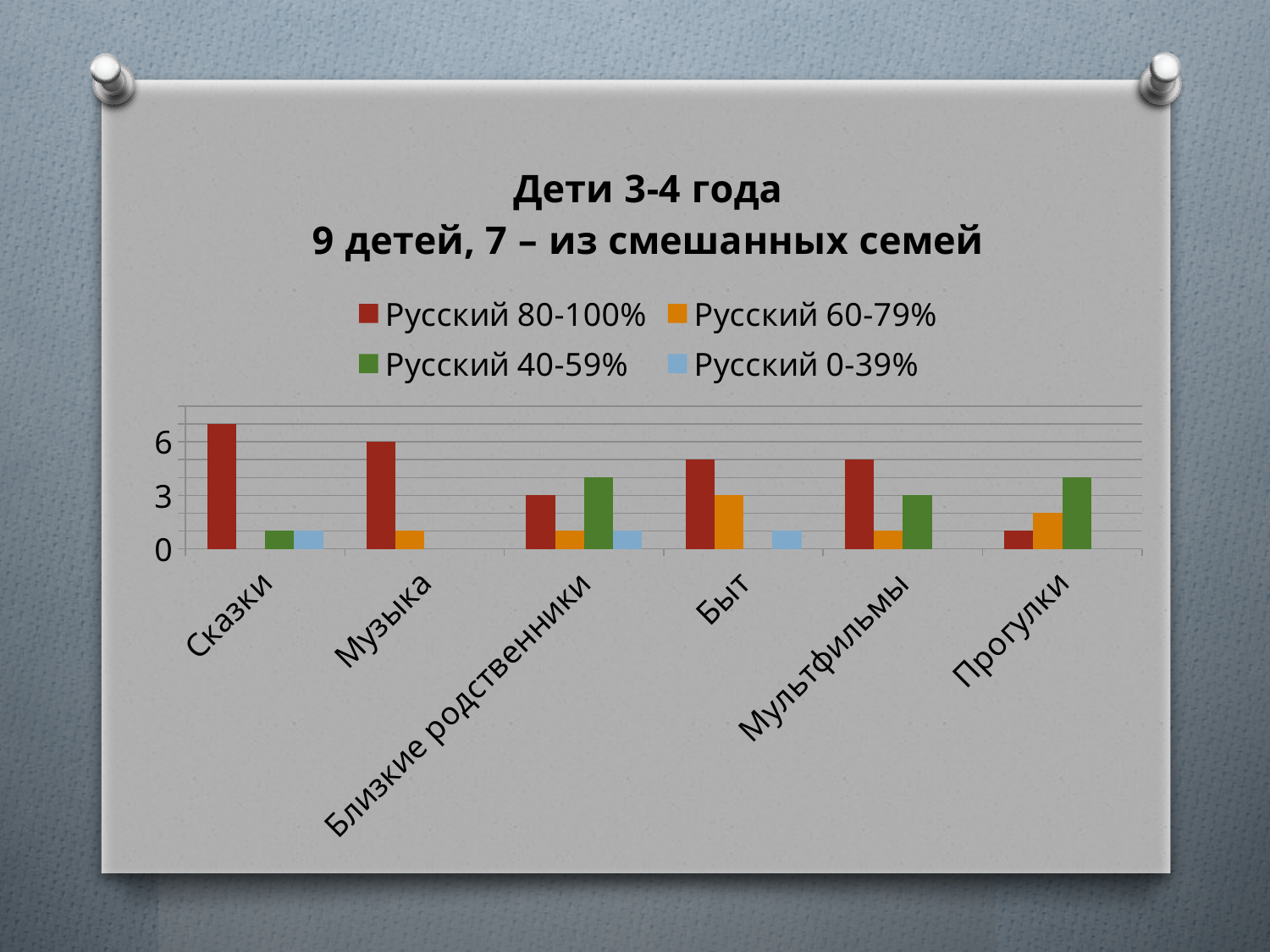
What is the value of the Русский 80-100% series for Близкие родственники? 3 What is the value of the Русский 40-59% series for Мультфильмы? 3 What is the value of the Русский 80-100% series for Музыка? 6 How many categories are shown on the x axis? 6 What kind of chart is shown on the slide? bar chart For Быт, which series has the larger value: Русский 80-100% or Русский 60-79%? Русский 80-100% Is the value of the Русский 40-59% series for Прогулки greater or less than 3? greater Is the value of the Русский 80-100% series for Сказки greater or less than 6? greater Which category has the highest value for the Русский 80-100% series? Сказки Which category has the lowest value for the Русский 80-100% series? Прогулки What is the value of the Русский 60-79% series for Быт? 3 How many series does the legend list? 4